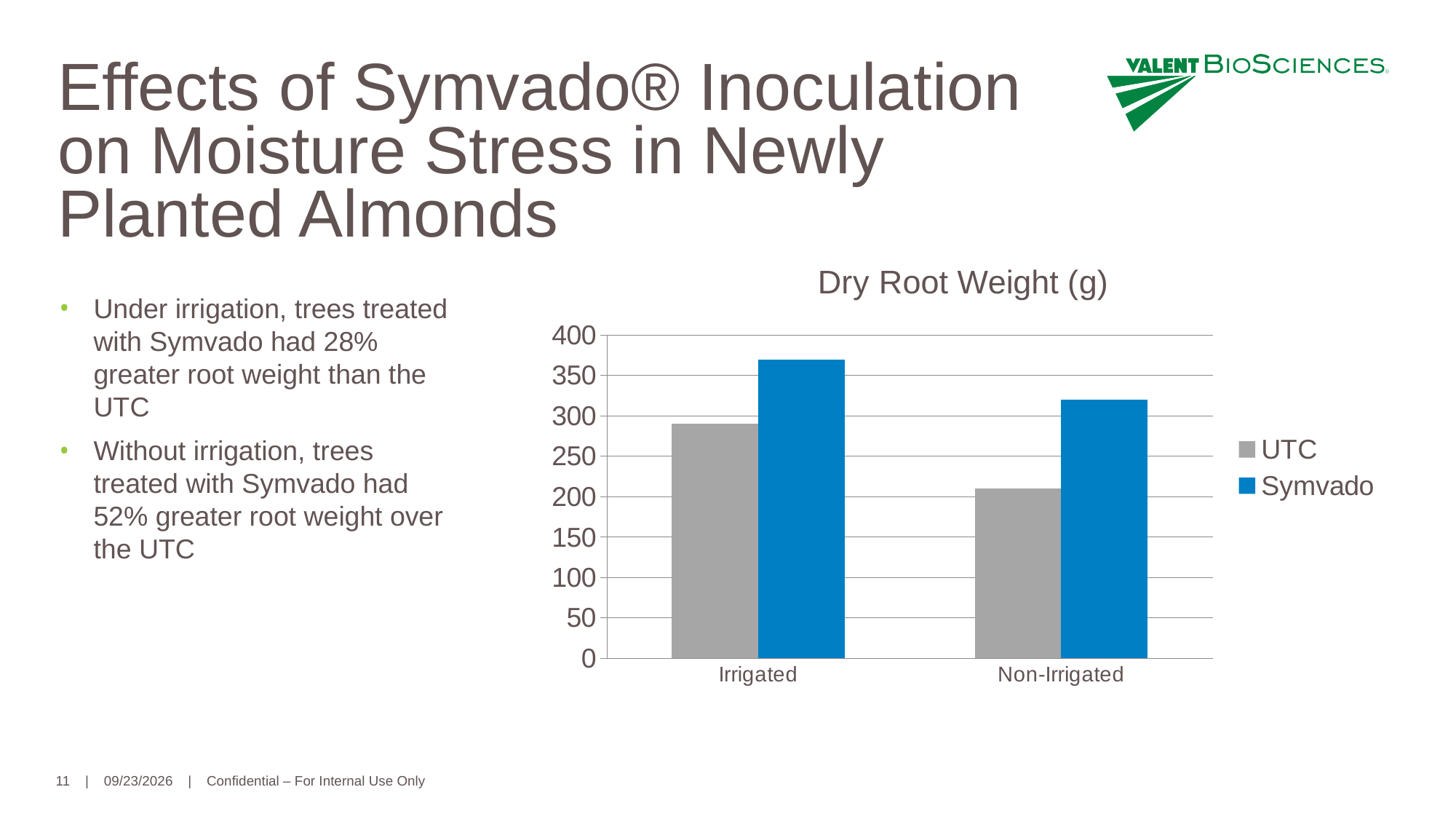
What kind of chart is shown on the slide? bar chart For the Symvado series, which category has the larger value, Irrigated or Non-Irrigated? Irrigated Which series is shown in blue in the chart? Symvado How many categories are shown on the x axis of the chart? 2 Is the UTC value for Irrigated greater or less than 250? greater Is the UTC value for Non-Irrigated greater or less than 250? less How many series does the chart legend list? 2 Which bar is the highest in the chart? Symvado, Irrigated Which bar is the lowest in the chart? UTC, Non-Irrigated Is the Symvado value for Irrigated greater or less than 350? greater What is the title of the chart? Dry Root Weight (g)